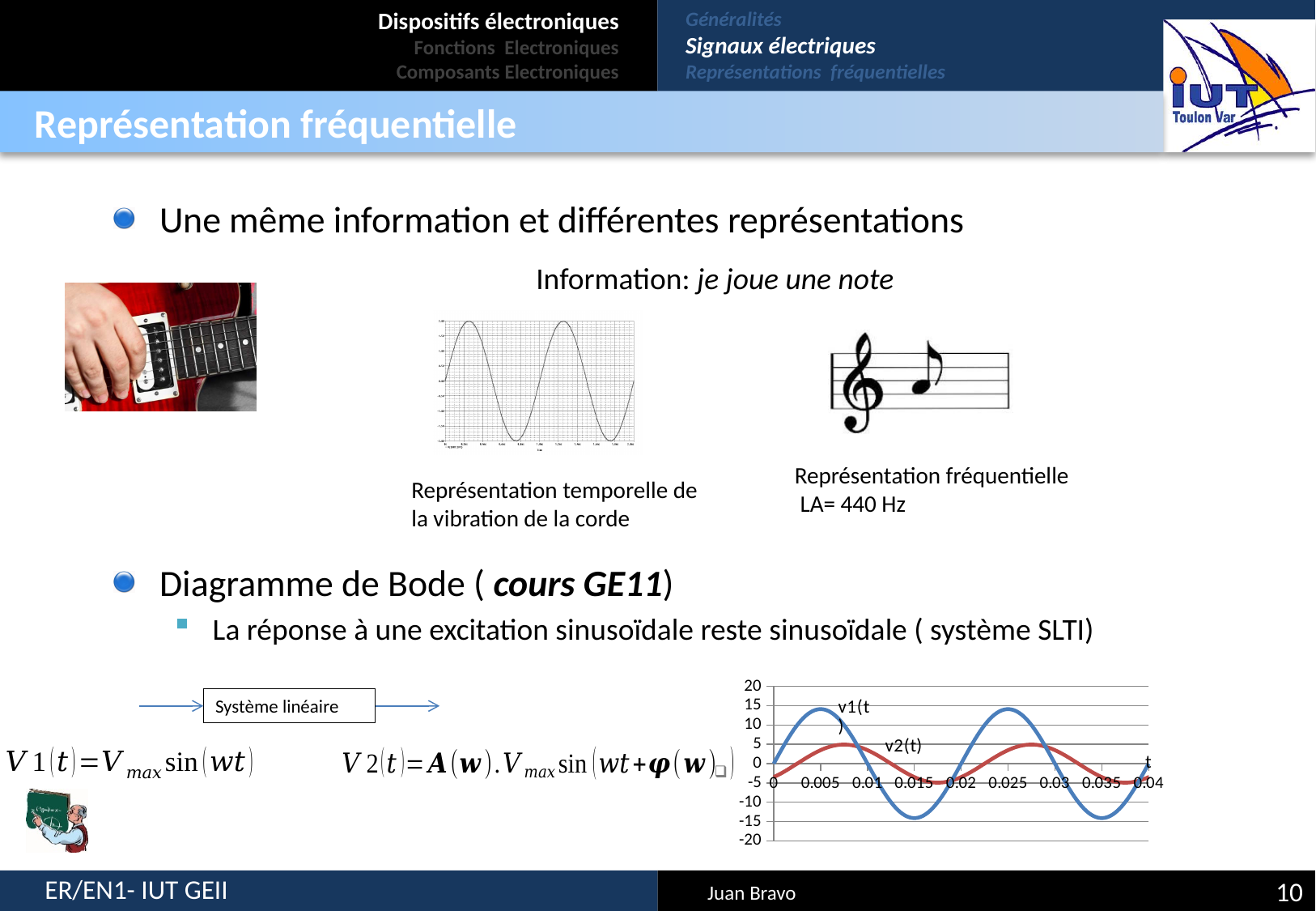
In the bottom-right chart, what colour is the v1(t) curve? blue In the bottom-right chart, is the peak value of v1(t) greater or less than 10? greater What kind of chart is shown at the bottom right of the slide? line chart What is the last tick value on the horizontal axis of the bottom-right chart? 0.04 How many tick labels are shown on the horizontal axis of the bottom-right chart? 9 In the bottom-right chart, does v1(t) rise or fall between t = 0 and t = 0.005? rise In the bottom-right chart, is the minimum value of v1(t) greater or less than -10? less What is the maximum value shown on the vertical axis of the bottom-right chart? 20 In the bottom-right chart, is the peak value of v2(t) greater or less than 10? less In the bottom-right chart, which series has the larger amplitude, v1(t) or v2(t)? v1(t) How many series are plotted in the bottom-right chart? 2 What are the names of the two series labelled in the bottom-right chart? v1(t) and v2(t)